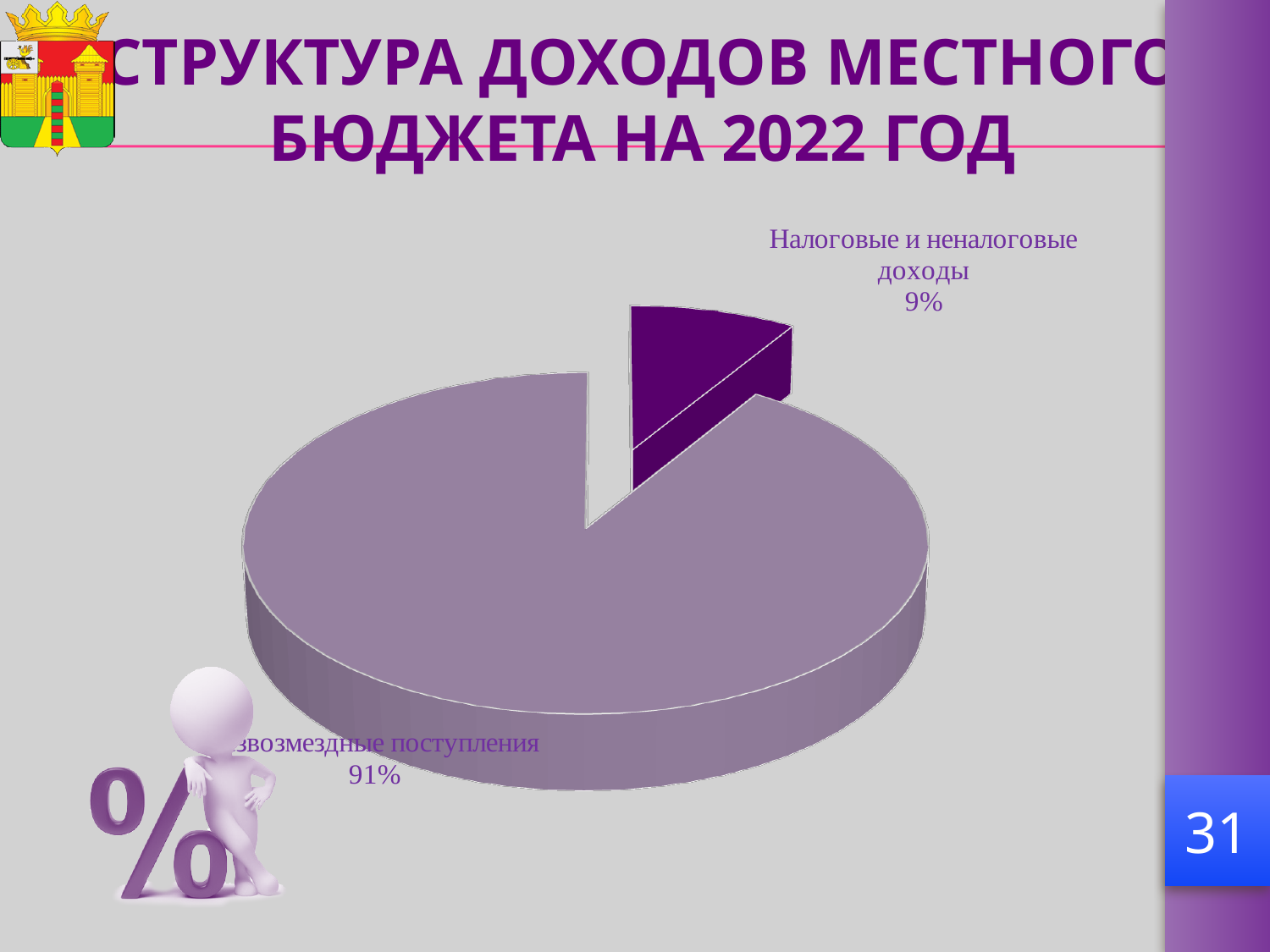
Which slice of the pie is drawn in dark purple and pulled out from the rest of the pie? Налоговые и неналоговые доходы What do the two slices of the pie chart add up to? 100% How many slices does the pie chart have? 2 What share of the pie is labelled "Налоговые и неналоговые доходы"? 9% What is the title of the slide containing the pie chart? СТРУКТУРА ДОХОДОВ МЕСТНОГО БЮДЖЕТА НА 2022 ГОД What is the difference in percentage points between the "Безвозмездные поступления" slice and the "Налоговые и неналоговые доходы" slice? 82 percentage points What kind of chart is shown on the slide? Pie chart Which slice of the pie is the largest? Безвозмездные поступления Which slice of the pie is the smallest? Налоговые и неналоговые доходы Which is larger: the share for "Налоговые и неналоговые доходы" or the share for "Безвозмездные поступления"? Безвозмездные поступления What share of the pie is labelled "Безвозмездные поступления"? 91%